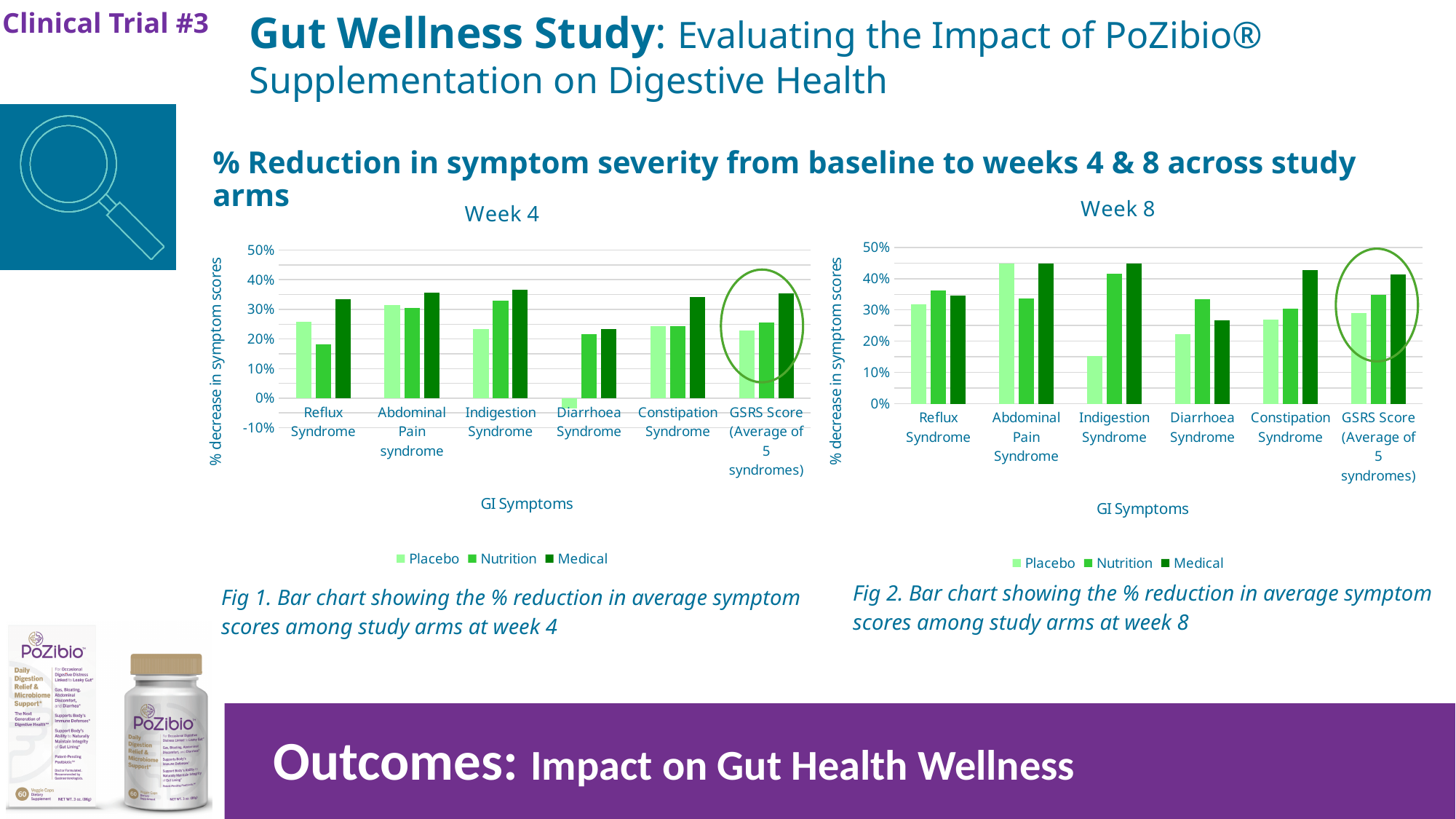
In the Week 8 chart, which series has the highest value for Constipation Syndrome? Medical How many series does the legend of the Week 8 chart list? 3 In the Week 4 chart, which series has the lowest value for Diarrhoea Syndrome? Placebo In the Week 8 chart, is the Placebo value for Indigestion Syndrome greater or less than 20%? less How many symptom categories are shown on the x axis of the Week 4 chart? 6 In the Week 8 chart, which is larger for Indigestion Syndrome, the Placebo value or the Medical value? Medical In the Week 4 chart, is the Placebo value for Diarrhoea Syndrome greater or less than 0%? less What kind of chart is the Week 4 chart? bar chart In the Week 8 chart, is the Medical value for Constipation Syndrome greater or less than 40%? greater What is the y-axis title of the Week 8 chart? % decrease in symptom scores